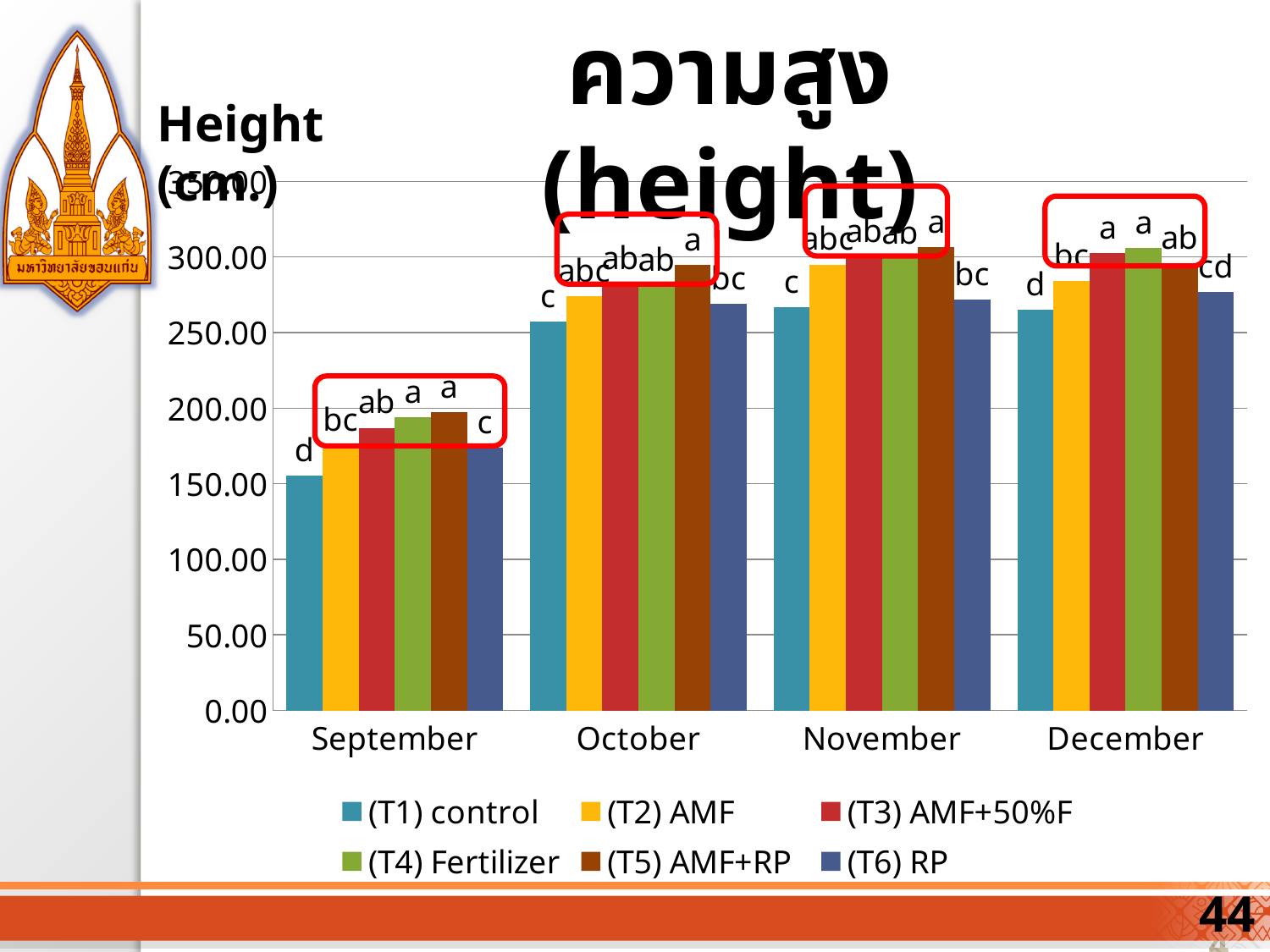
Is the value for (T1) control in September greater or less than 200? less Is the value for (T5) AMF+RP in October greater or less than 250? greater What kind of chart is shown on the slide? bar chart Is the value for (T1) control in December greater or less than 250? greater What is the label on the y axis of the chart? Height (cm.) How many months (categories) are shown on the x axis? 4 How many series does the legend list? 6 In December, which is larger: the value for (T4) Fertilizer or the value for (T1) control? (T4) Fertilizer Does the value for (T1) control rise or fall from September to October? rise Which series has the lowest value in December? (T1) control Which series has the lowest value in September? (T1) control In September, which is larger: the value for (T1) control or the value for (T5) AMF+RP? (T5) AMF+RP